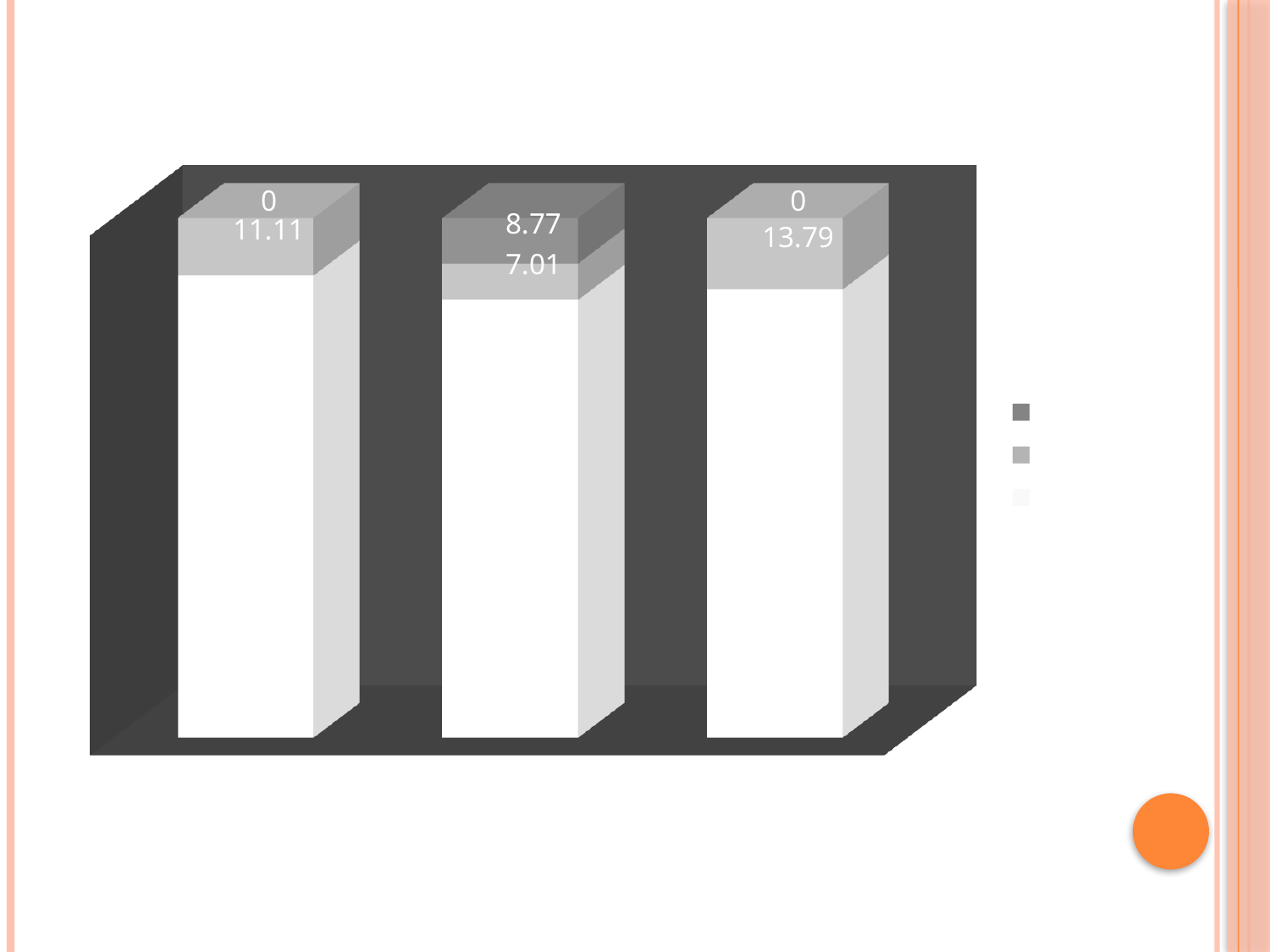
What value is labelled on the light grey segment of the middle bar? 7.01 What value is labelled on the topmost (dark grey) segment of the middle bar? 8.77 How many bars are plotted in the chart? 3 What is the difference between the light grey segment values of the right bar (13.79) and the left bar (11.11)? 2.68 What value is labelled on the light grey segment of the right bar? 13.79 In the middle bar, which labelled segment value is larger: 8.77 or 7.01? 8.77 What value is labelled on the topmost (dark grey) segment of the left bar? 0 What value is labelled on the light grey segment of the left bar? 11.11 Which bar has the largest labelled value on its light grey segment: the left, middle or right bar? Right bar What value is labelled on the topmost (dark grey) segment of the right bar? 0 How many series does the legend list? 3 What kind of chart is shown on the slide? Bar chart